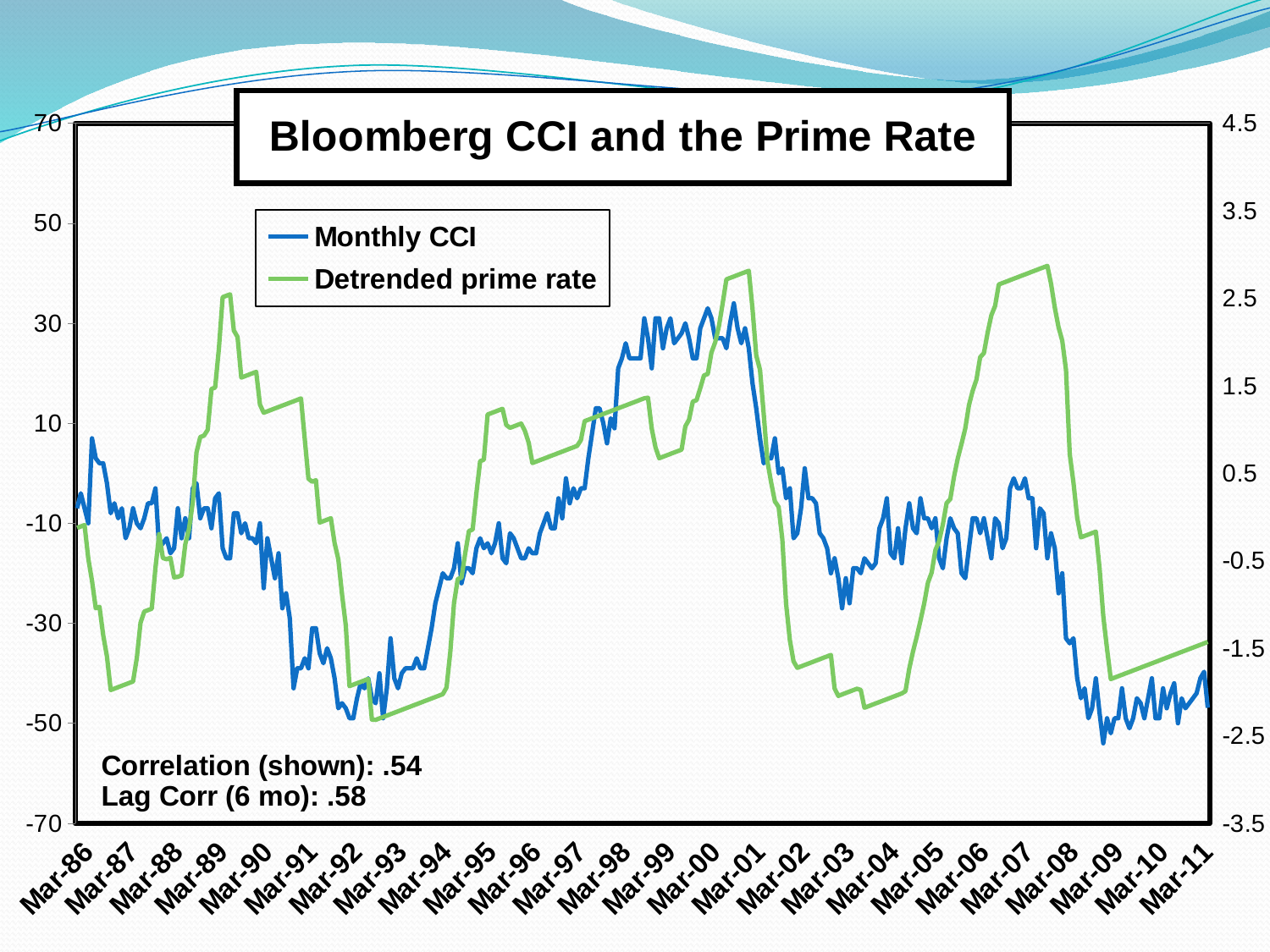
How many date labels are shown on the x axis? 26 Does the Detrended prime rate line rise or fall between Mar-05 and Mar-07? rise What is the title of the chart? Bloomberg CCI and the Prime Rate Is the Detrended prime rate value at Mar-87 greater or less than -0.5? less Is the Monthly CCI value at Mar-09 greater or less than -30? less Is the Monthly CCI value at Mar-99 greater or less than 10? greater Does the Monthly CCI line rise or fall between Mar-08 and Mar-09? fall What kind of chart is shown on the slide? line chart How many series does the legend list? 2 What correlation value is shown on the chart? .54